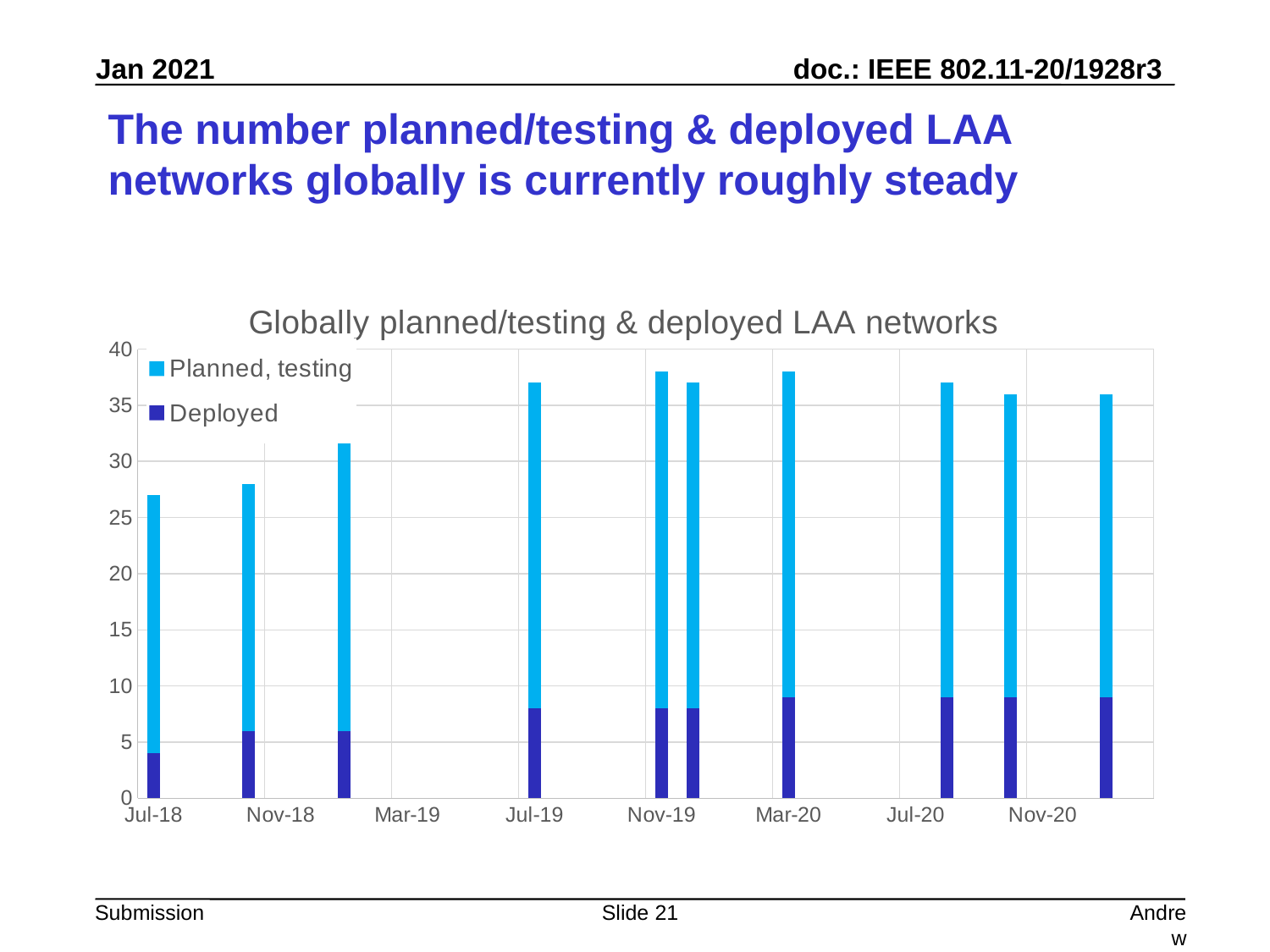
Is the Deployed value at Jul-18 greater or less than 5? less What kind of chart is shown on the slide? stacked bar chart What is the title of the chart? Globally planned/testing & deployed LAA networks Is the total height of the bar at Jul-18 greater or less than 25? greater What are the two series named in the legend? Planned, testing; Deployed Is the Deployed value at Mar-20 greater or less than 10? less Which is larger, the total bar at Jul-18 or the total bar at Jul-19? Jul-19 How many bars are plotted in the chart? 10 Does the total number of networks rise or fall from Jul-18 to Jul-19? rise How many series does the legend list? 2